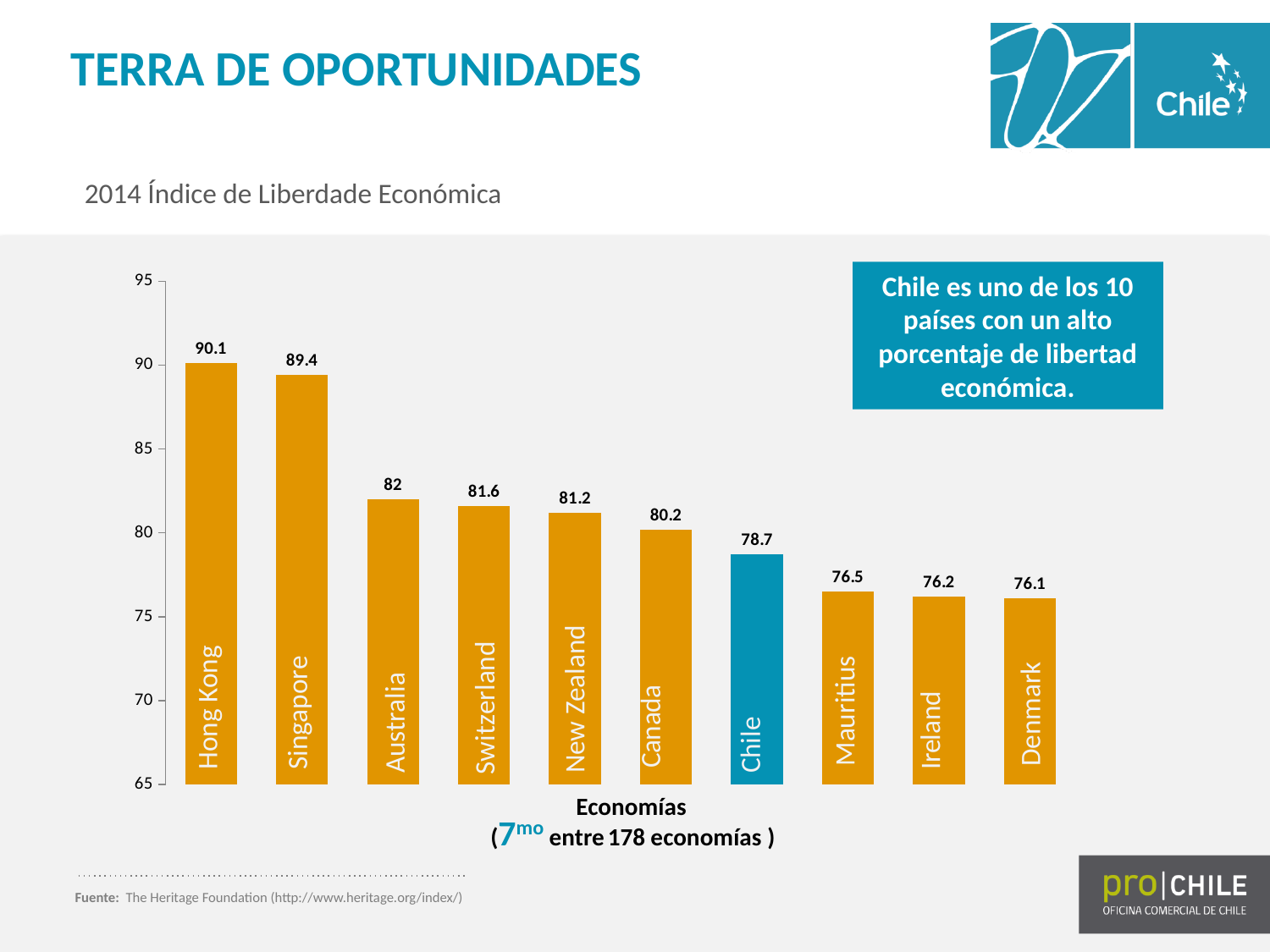
Which economy has the lowest value? Denmark What is the value for Switzerland? 81.6 Is the value for Ireland greater or less than 80? less What is the value for Mauritius? 76.5 What is the difference between the values for Hong Kong and Singapore? 0.7 Which economy has the highest value? Hong Kong Which is larger, the value for Canada or the value for New Zealand? New Zealand How many economies are shown in the chart? 10 What kind of chart is shown on the slide? bar chart What is the value for Chile? 78.7 What is the difference between the values for Australia and Chile? 3.3 Which bar is coloured differently from the others? Chile